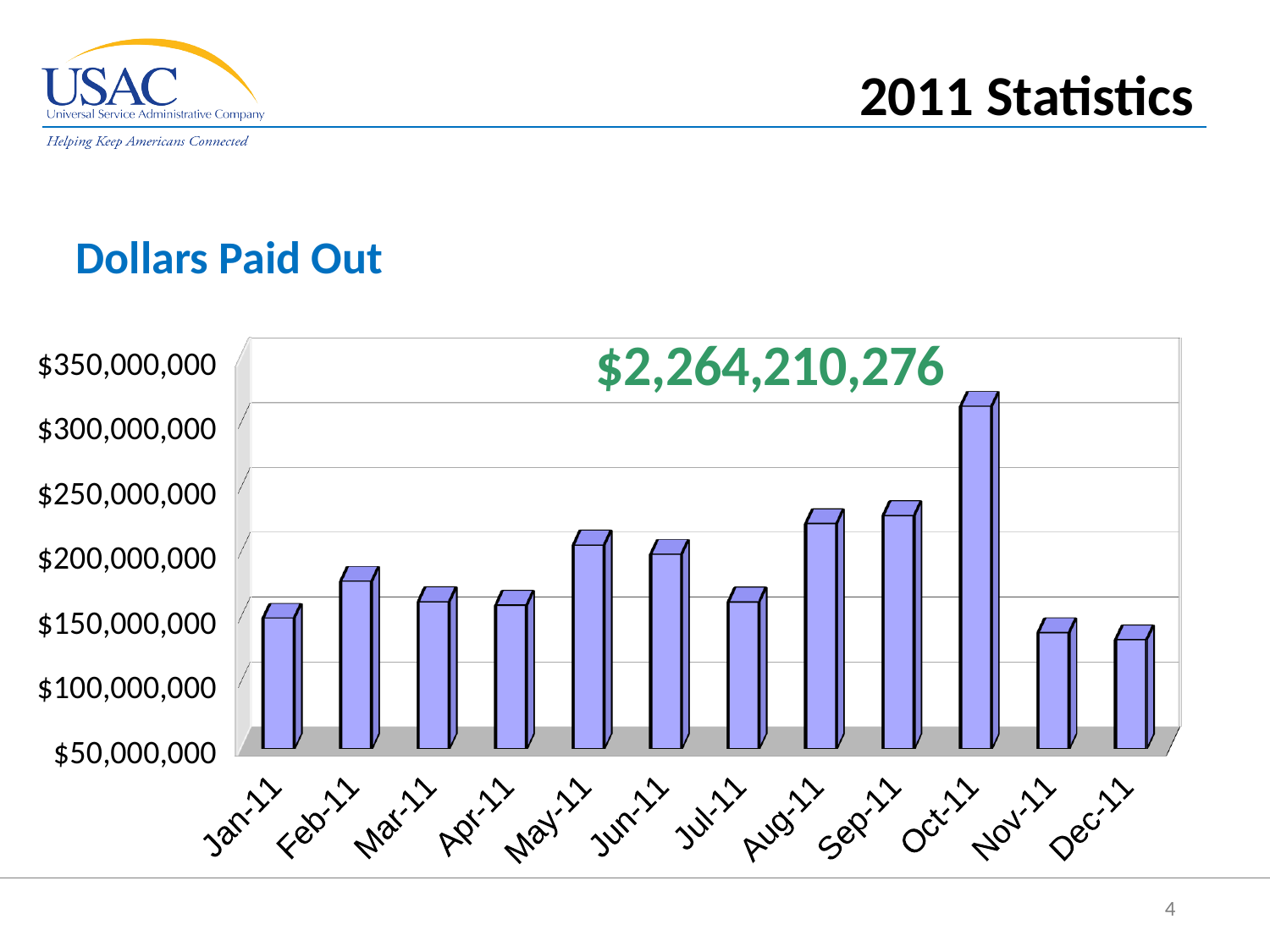
Is the value for Dec-11 greater or less than $150,000,000? less Which month has the highest dollars paid out? Oct-11 Is the value for Oct-11 greater or less than $300,000,000? greater Is the value for Feb-11 greater or less than $200,000,000? less Which is larger, the value for Sep-11 or the value for Oct-11? Oct-11 What kind of chart is shown on the slide? bar chart How many months are plotted on the x axis of the chart? 12 What is the title of the chart? Dollars Paid Out What total amount is printed in green above the bars? $2,264,210,276 Which is larger, the value for Jan-11 or the value for Feb-11? Feb-11